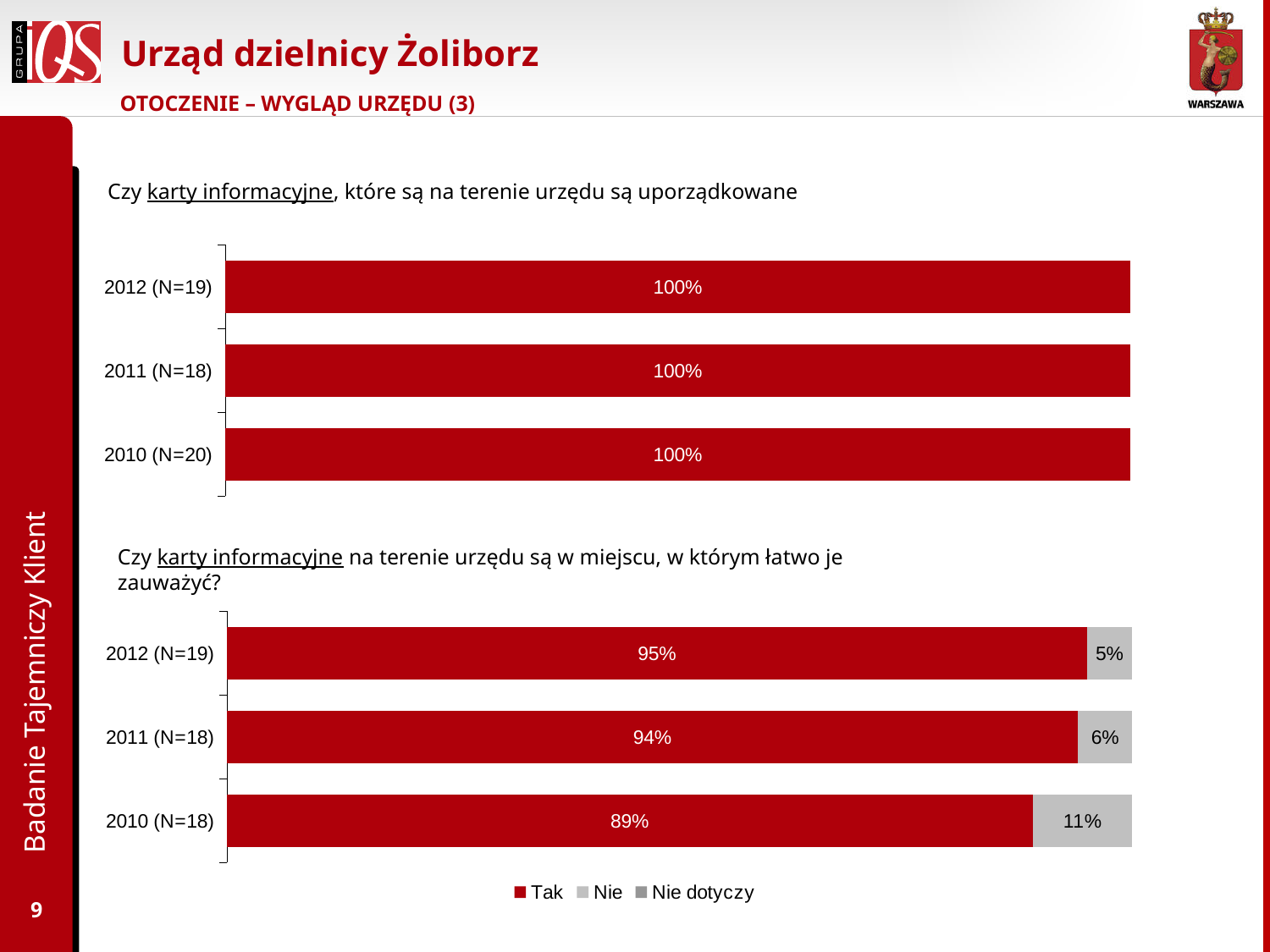
In the bottom chart (karty informacyjne łatwo je zauważyć), what is the 'Tak' value for 2011 (N=18)? 94% In the bottom chart (karty informacyjne łatwo je zauważyć), which year has the lowest 'Tak' value? 2010 (N=18) In the bottom chart (karty informacyjne łatwo je zauważyć), what is the 'Tak' value for 2012 (N=19)? 95% How many series does the legend at the bottom of the slide list? 3 In the bottom chart (karty informacyjne łatwo je zauważyć), what is the total of the 'Tak' and 'Nie' segments for 2011 (N=18)? 100% In the bottom chart (karty informacyjne łatwo je zauważyć), what is the difference between the 'Tak' values for 2012 (N=19) and 2010 (N=18)? 6 percentage points In the bottom chart (karty informacyjne łatwo je zauważyć), is the 'Nie' value larger for 2011 (N=18) or for 2012 (N=19)? 2011 (N=18) How many year categories does the top chart (karty informacyjne są uporządkowane) show? 3 In the bottom chart (karty informacyjne łatwo je zauważyć), what is the 'Nie' value for 2010 (N=18)? 11% What type of chart is the bottom chart (karty informacyjne łatwo je zauważyć)? Stacked horizontal bar chart In the bottom chart (karty informacyjne łatwo je zauważyć), which year has the highest 'Nie' value? 2010 (N=18) In the top chart (karty informacyjne są uporządkowane), what is the value shown for 2010 (N=20)? 100%